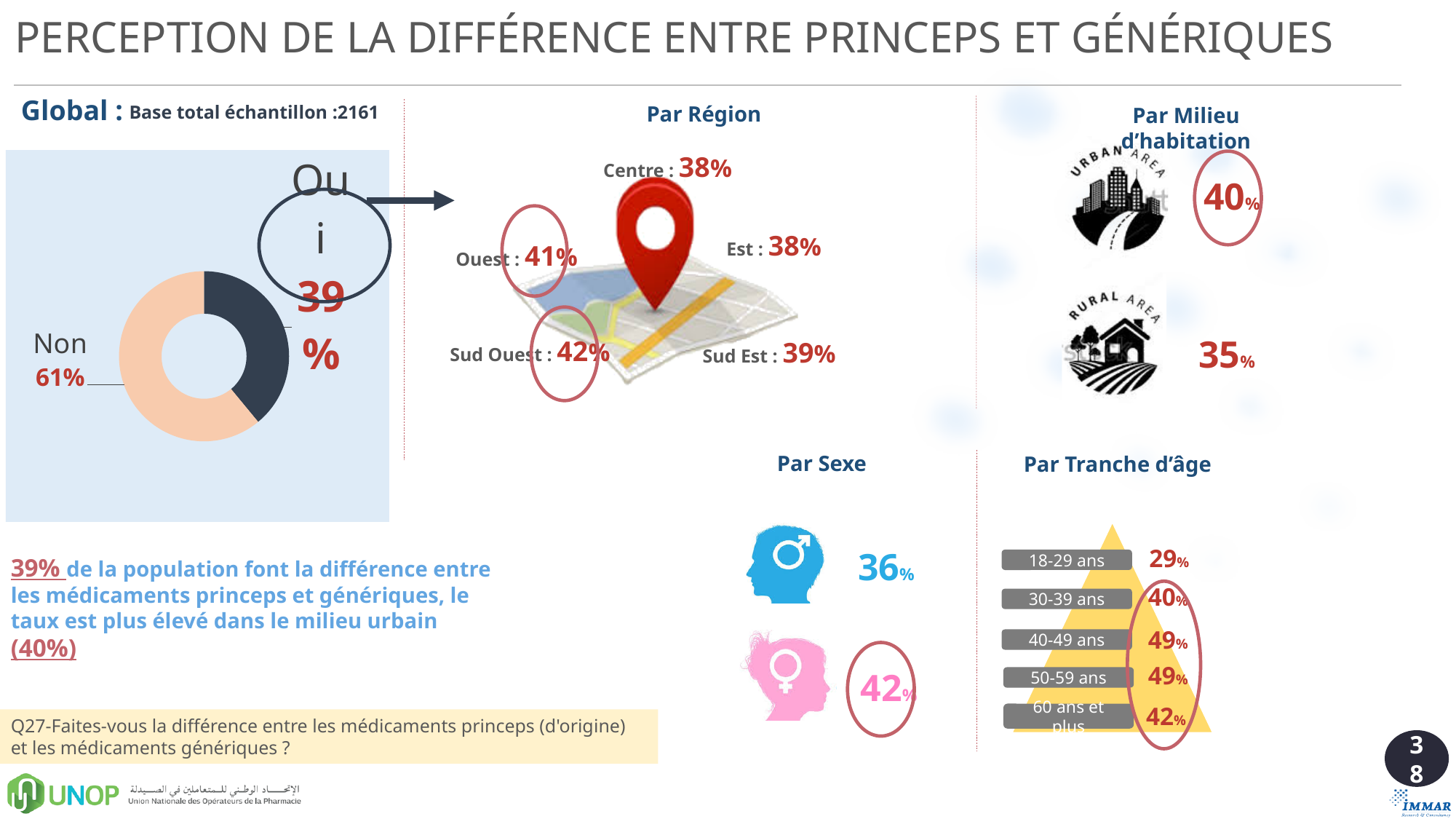
How many slices does the Global donut chart have? 2 In the Global donut chart, what percentage is shown for "Oui"? 39% In the "Par Région" map, which region has the highest percentage? Sud Ouest In the "Par Tranche d'âge" pyramid chart, what is the value for "18-29 ans"? 29% In the "Par Sexe" section, what is the difference between the female and male percentages? 6% How many age groups are shown in the "Par Tranche d'âge" pyramid chart? 5 In the Global donut chart, what percentage is shown for "Non"? 61% What is the base total sample size stated next to the Global donut chart? 2161 In the Global donut chart, what is the difference between the "Non" and "Oui" percentages? 22% In the "Par Tranche d'âge" pyramid chart, which age group has the lowest value? 18-29 ans In the Global donut chart, which slice is larger, "Oui" or "Non"? Non What kind of chart is used in the Global section on the left of the slide? Donut (pie) chart